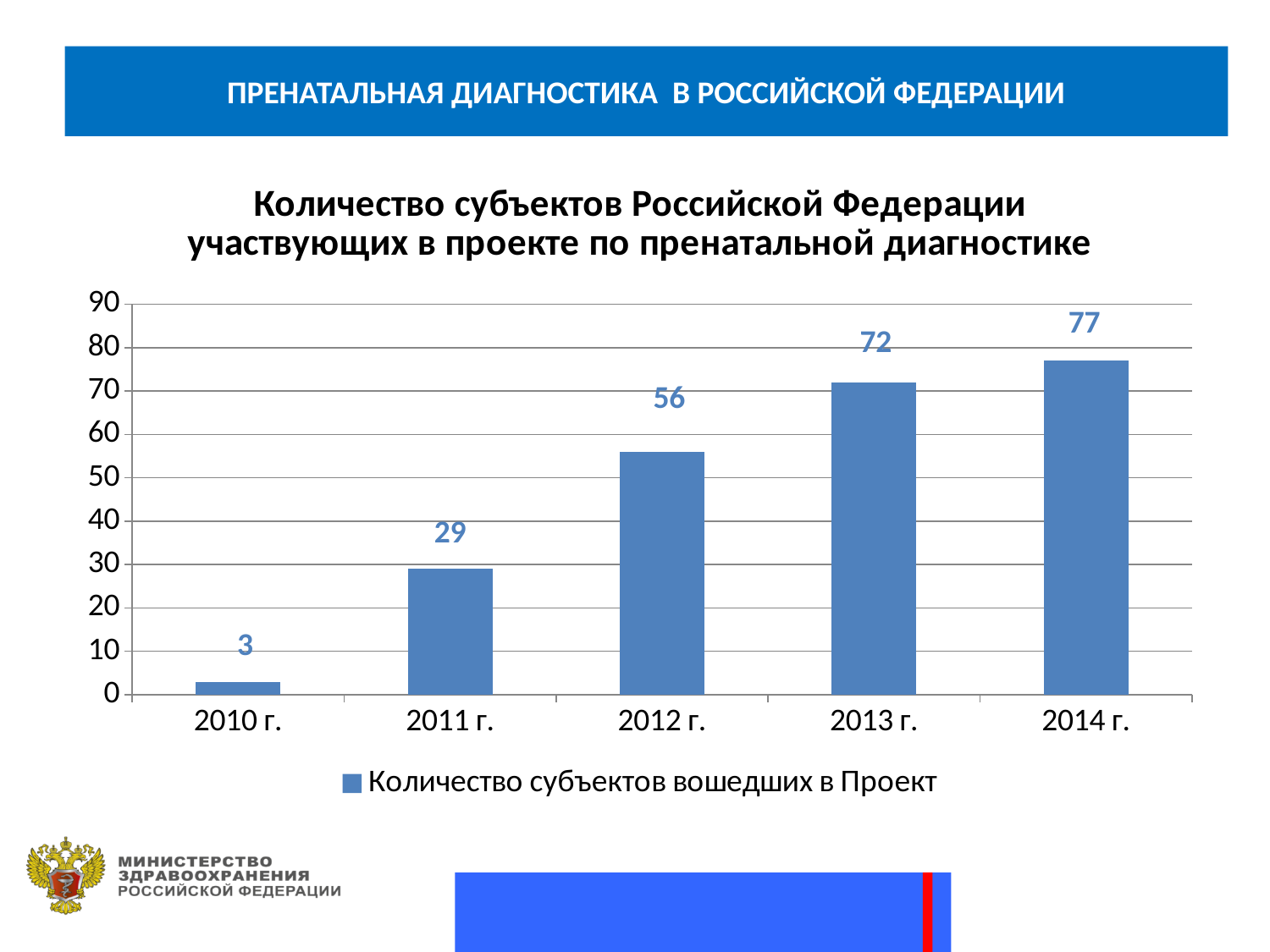
How many series does the legend list? 1 What kind of chart is shown? bar chart What is the value for 2012 г.? 56 Which year has the highest value? 2014 г. How many years are shown on the x axis? 5 Is the value for 2011 г. greater or less than 40? less What is the value for 2014 г.? 77 Which is larger, the value for 2012 г. or the value for 2013 г.? 2013 г. Which year has the lowest value? 2010 г. What is the value for 2010 г.? 3 Do the values rise or fall from 2010 г. to 2014 г.? rise What is the difference between the values for 2013 г. and 2011 г.? 43